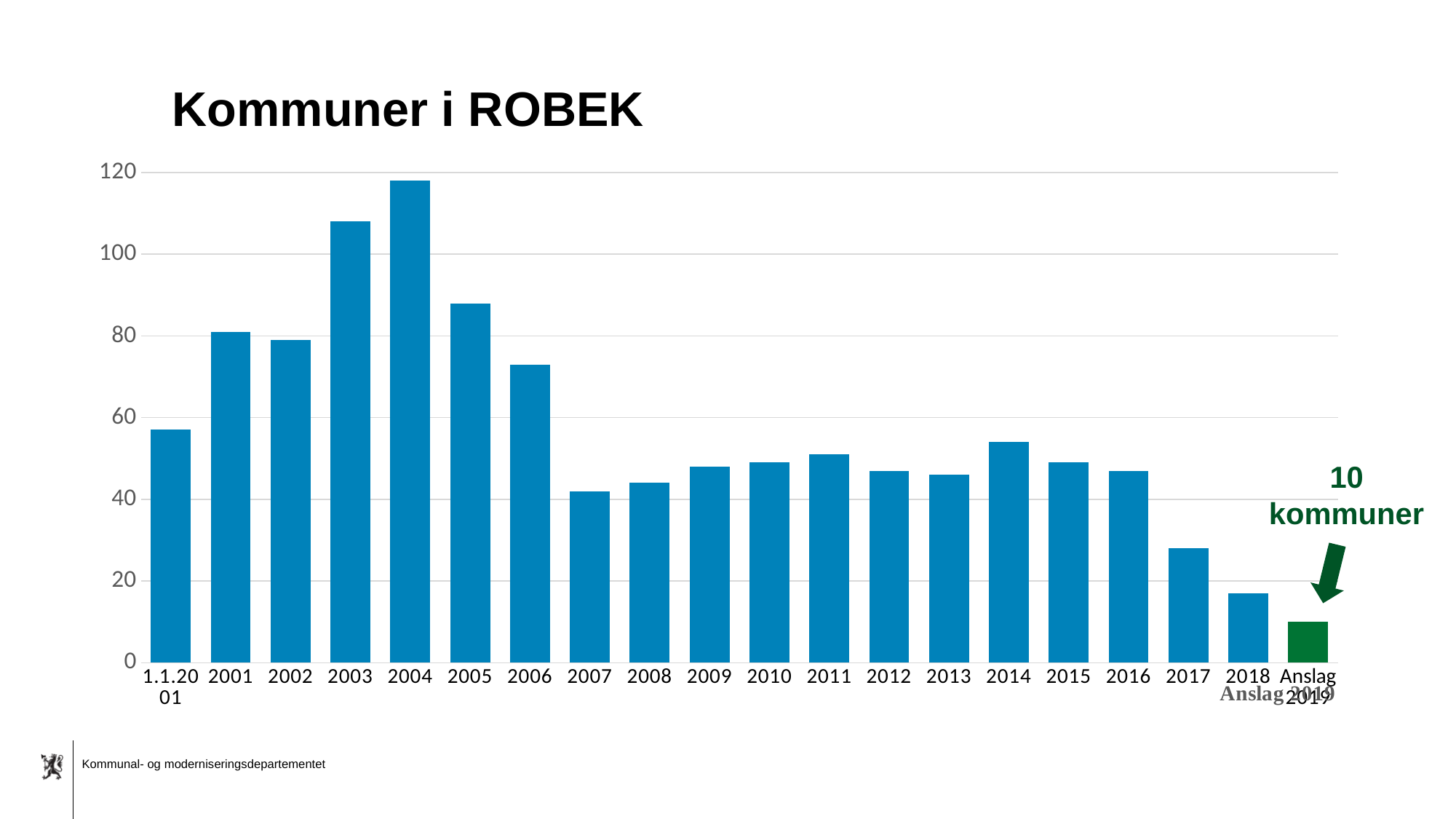
Which year has the highest number of kommuner i ROBEK? 2004 How many bars (categories) are plotted in the chart? 20 Is the value for 2004 greater or less than 100? greater Do the values rise or fall from 2014 to Anslag 2019? fall What is the title of the chart? Kommuner i ROBEK Is the value for 2018 greater or less than 20? less Which is larger, the value for 2003 or the value for 2005? 2003 Is the value for 2006 greater or less than 60? greater What is the value shown for Anslag 2019? 10 Which is larger, the value for 2017 or the value for 2018? 2017 What kind of chart is shown on the slide? bar chart Which category has the lowest value in the chart? Anslag 2019